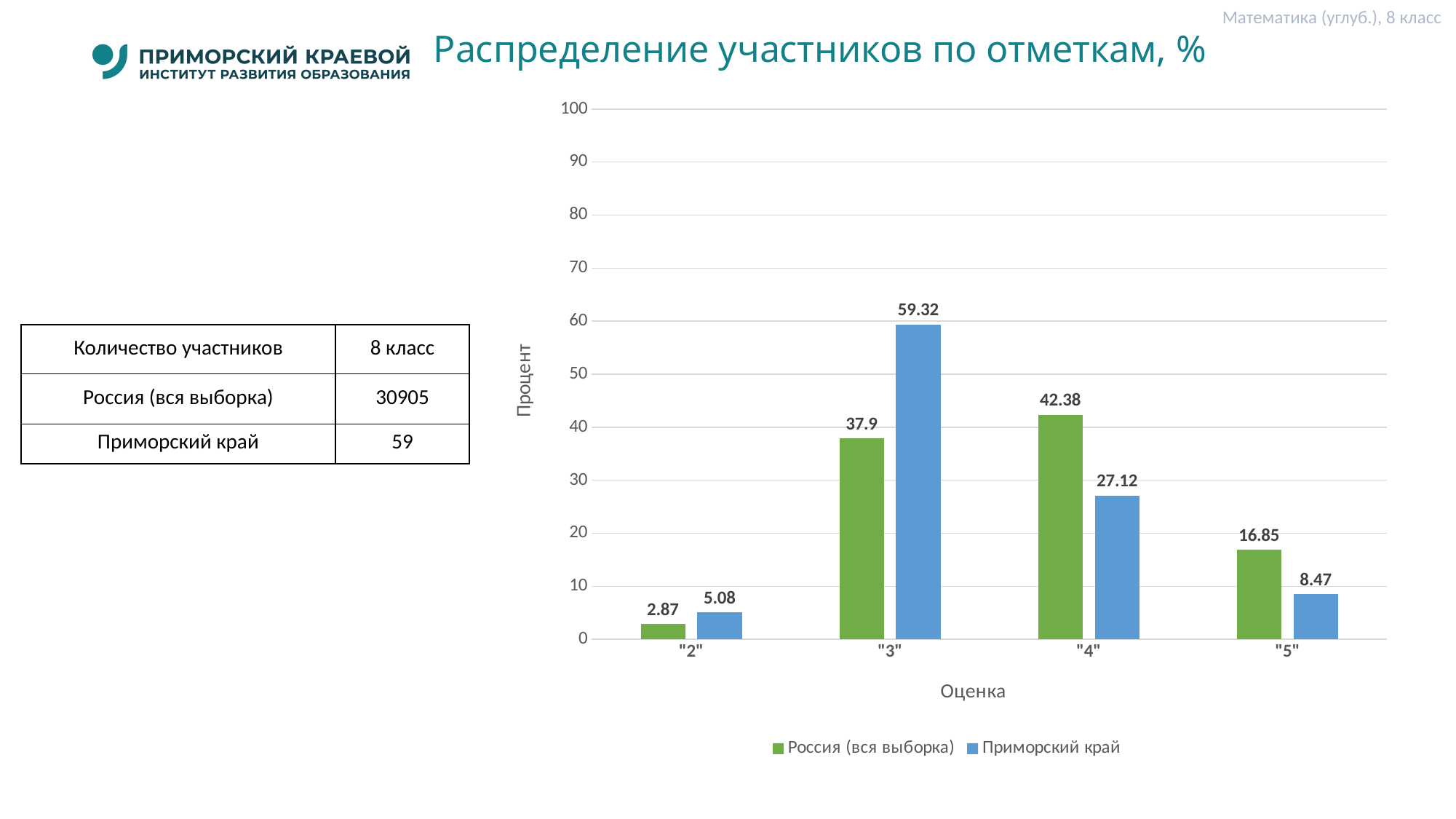
What is the value for Приморский край at grade "5"? 8.47 Which grade has the lowest value for Приморский край? "2" What is the value for Приморский край at grade "3"? 59.32 What is the title of the chart? Распределение участников по отметкам, % What is the value for Россия (вся выборка) at grade "4"? 42.38 Which grade has the highest value for Россия (вся выборка)? "4" What is the difference between Приморский край and Россия (вся выборка) at grade "3"? 21.42 How many series does the legend list? 2 What is the value for Россия (вся выборка) at grade "2"? 2.87 What kind of chart is shown on the slide? Bar chart Which is larger at grade "4": Россия (вся выборка) or Приморский край? Россия (вся выборка) How many grade categories are shown on the x axis? 4